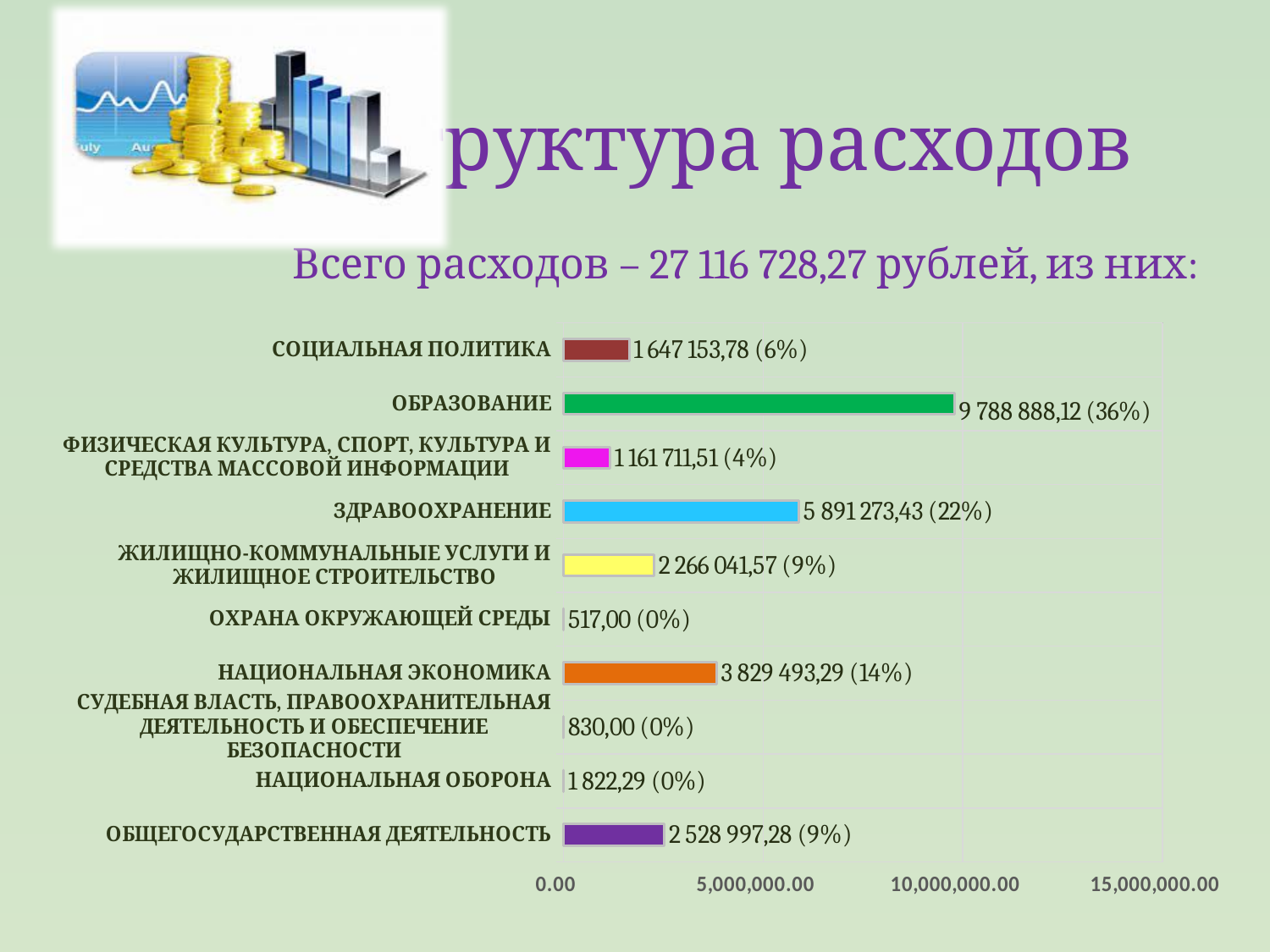
What percentage is shown for НАЦИОНАЛЬНАЯ ЭКОНОМИКА? 14% Which category has the highest value? ОБРАЗОВАНИЕ What is the difference between the values for ОБРАЗОВАНИЕ and ЗДРАВООХРАНЕНИЕ? 3 897 614,69 Which category has the lowest value? ОХРАНА ОКРУЖАЮЩЕЙ СРЕДЫ Which is larger, the value for ОБЩЕГОСУДАРСТВЕННАЯ ДЕЯТЕЛЬНОСТЬ or the value for СОЦИАЛЬНАЯ ПОЛИТИКА? ОБЩЕГОСУДАРСТВЕННАЯ ДЕЯТЕЛЬНОСТЬ Is the value for ЗДРАВООХРАНЕНИЕ greater or less than 5,000,000.00? greater What total expenditure is stated in the subtitle above the chart? 27 116 728,27 рублей What kind of chart is shown on the slide? Bar chart How many categories does the chart show? 10 What is the value shown for НАЦИОНАЛЬНАЯ ОБОРОНА? 1 822,29 (0%) What is the value shown for ЗДРАВООХРАНЕНИЕ? 5 891 273,43 (22%) What is the value shown for ОБРАЗОВАНИЕ? 9 788 888,12 (36%)